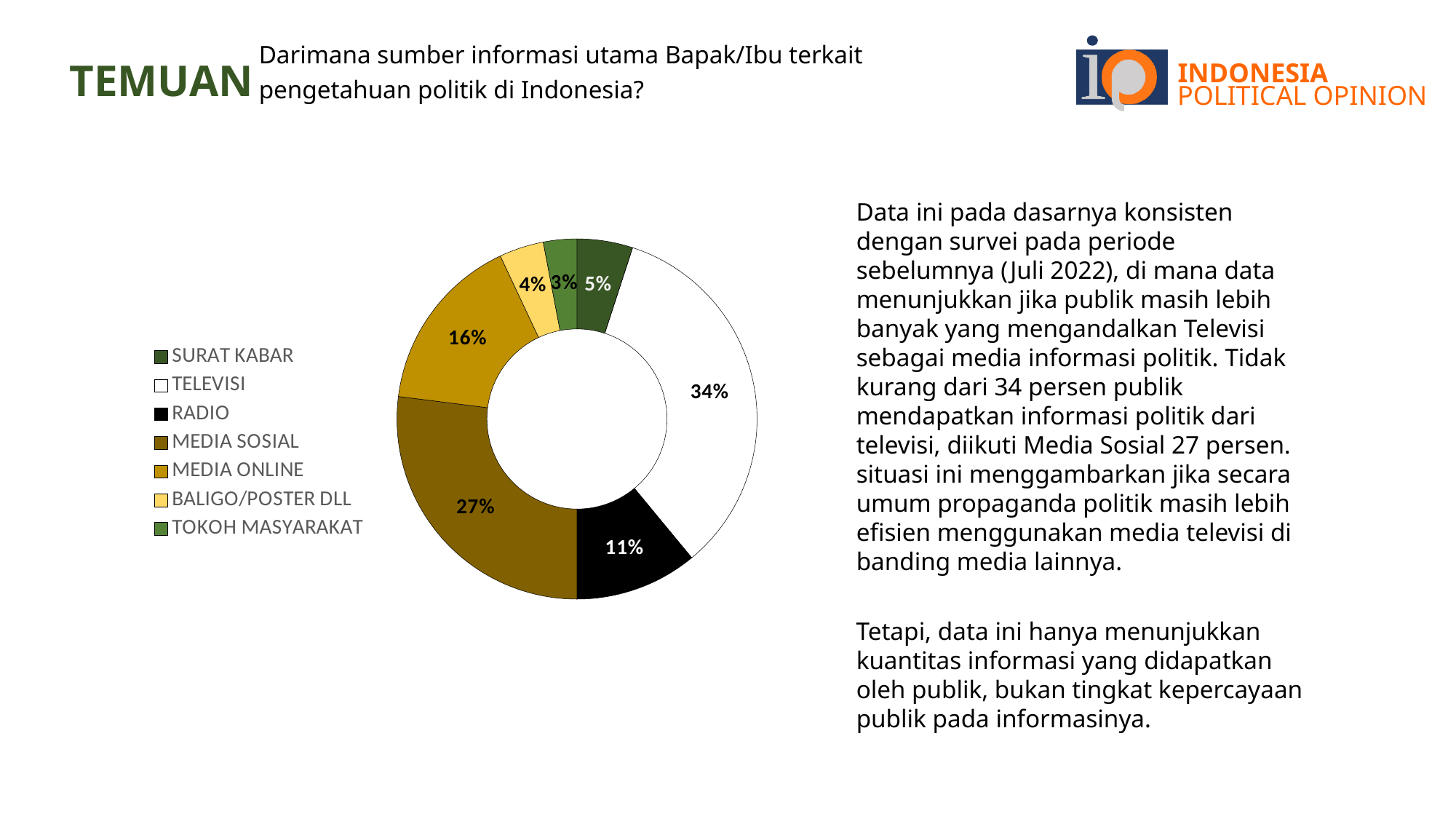
What is the value for MEDIA ONLINE? 16% What share does RADIO have in the chart? 11% What kind of chart is shown on the slide? doughnut chart What is the value shown for MEDIA SOSIAL? 27% How many categories does the chart show? 7 Which category has the largest share in the chart? TELEVISI What is the difference in percentage points between TELEVISI and MEDIA SOSIAL? 7 What percentage is shown for BALIGO/POSTER DLL? 4% Which category has the smallest share in the chart? TOKOH MASYARAKAT Which is larger, the share for MEDIA ONLINE or the share for RADIO? MEDIA ONLINE Which category is represented by the white segment? TELEVISI What percentage of respondents cited TELEVISI as their main source of political information? 34%